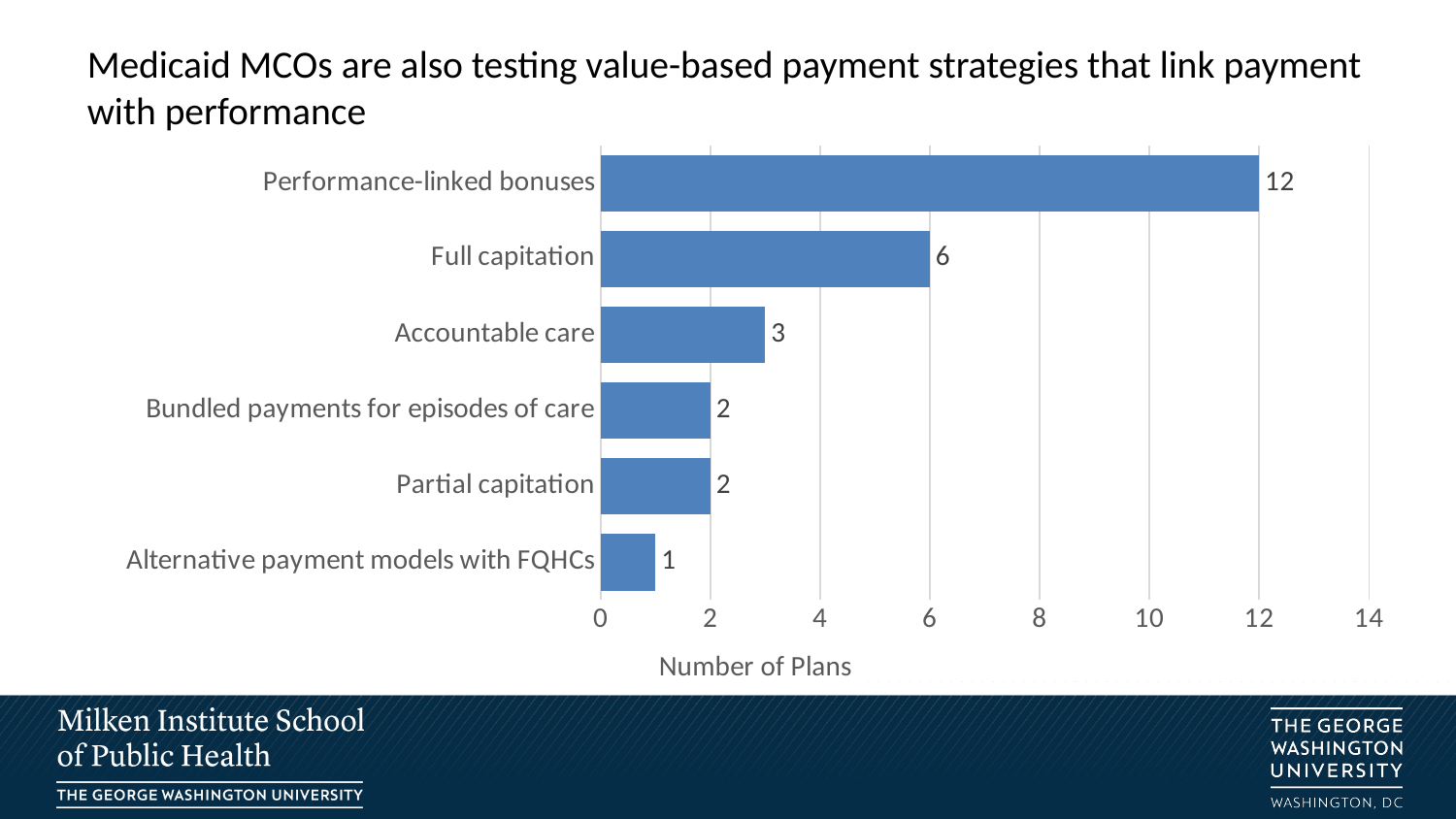
What kind of chart is shown on the slide? Bar chart What is the label of the horizontal axis? Number of Plans Which payment strategy has the lowest number of plans? Alternative payment models with FQHCs What is the difference in number of plans between accountable care and bundled payments for episodes of care? 1 How many payment strategies are shown in the chart? 6 Which payment strategy has the highest number of plans? Performance-linked bonuses What is the difference in number of plans between performance-linked bonuses and full capitation? 6 Is the value for full capitation greater or less than 4? greater Which has more plans, accountable care or partial capitation? Accountable care What is the number of plans for full capitation? 6 How many plans use performance-linked bonuses? 12 How many plans use alternative payment models with FQHCs? 1